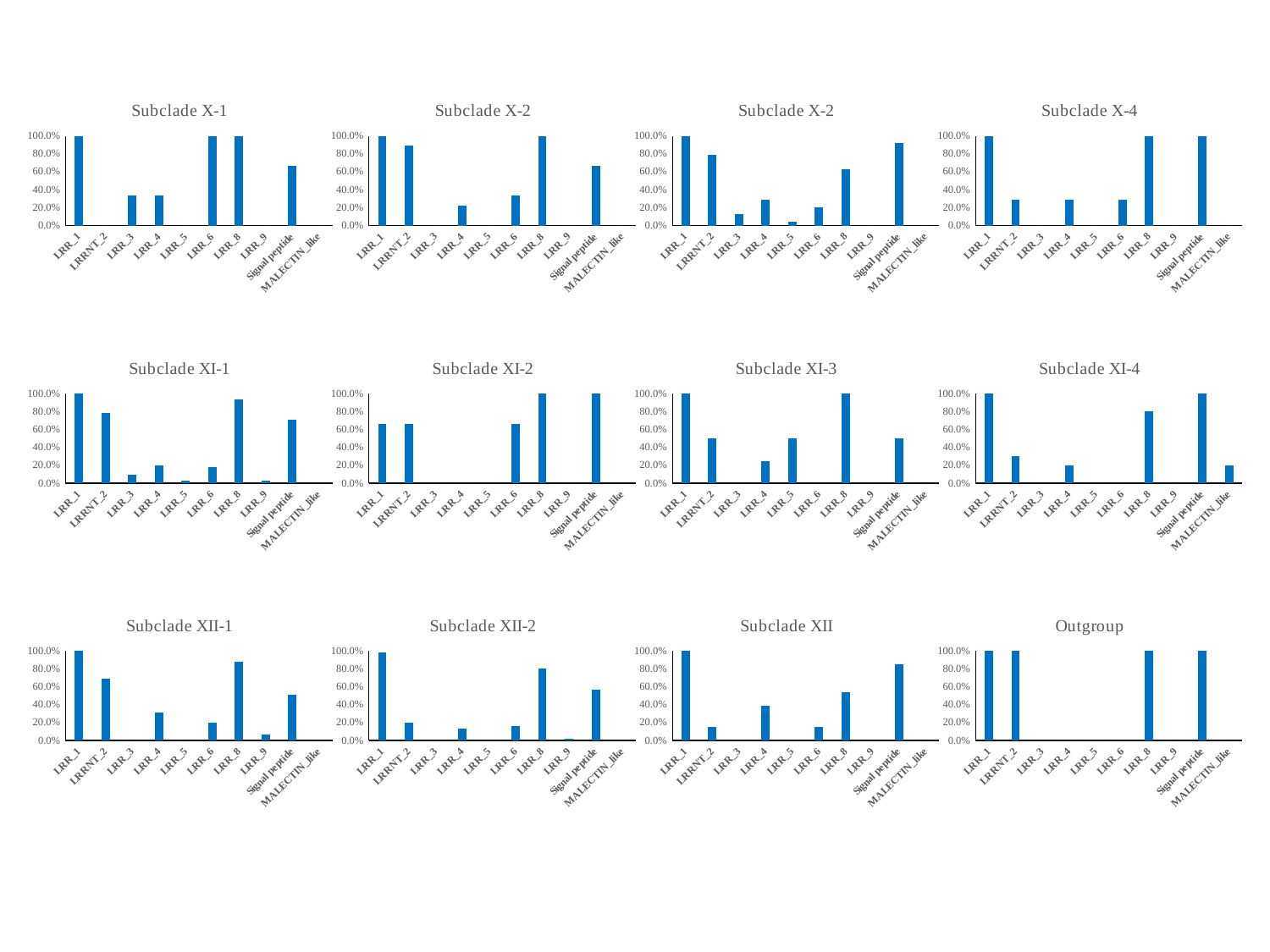
How many charts are shown on the slide? 12 In the Subclade XII chart (third chart in the bottom row), which is larger, the value for LRR_4 or the value for LRR_8? LRR_8 What kind of chart is the Subclade X-1 chart? bar chart In the Subclade XII-1 chart, which is larger, the value for LRRNT_2 or the value for Signal peptide? LRRNT_2 In the third chart of the top row (titled Subclade X-2), is the value for Signal peptide greater or less than 80.0%? greater In the Subclade XII-2 chart, which category has the highest value? LRR_1 In the Subclade XI-3 chart, is the value for LRR_4 greater or less than 40.0%? less In the Subclade XI-2 chart, what is the value for Signal peptide? 100.0% In the Outgroup chart, what is the value for LRR_1? 100.0% In the Subclade X-1 chart, is the value for Signal peptide greater or less than 60.0%? greater How many categories are shown on the x axis of the Subclade XI-1 chart? 10